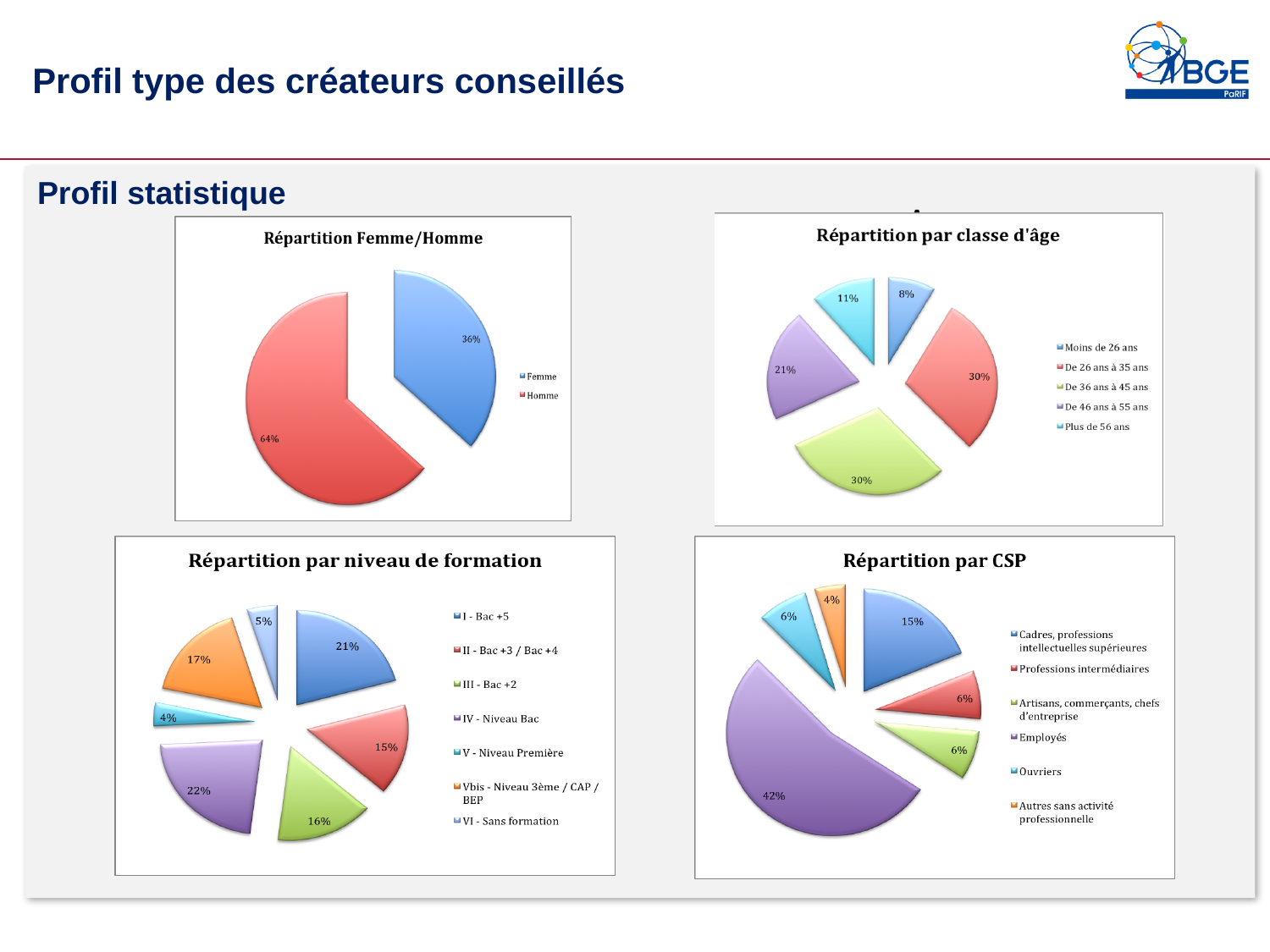
In the 'Répartition par niveau de formation' chart, what share is labelled for 'Vbis - Niveau 3ème / CAP / BEP'? 17% In the 'Répartition par niveau de formation' chart, which is larger: the share for 'I - Bac +5' or for 'II - Bac +3 / Bac +4'? I - Bac +5 In the 'Répartition Femme/Homme' chart, what share is labelled for Homme? 64% In the 'Répartition Femme/Homme' chart, what share is labelled for Femme? 36% In the 'Répartition par classe d'âge' chart, what share is labelled for 'Plus de 56 ans'? 11% In the 'Répartition par classe d'âge' chart, what is the difference between the shares for 'De 46 ans à 55 ans' and 'Moins de 26 ans'? 13% In the 'Répartition par classe d'âge' chart, how many age classes does the legend list? 5 In the 'Répartition par CSP' chart, which category has the smallest share? Autres sans activité professionnelle In the 'Répartition par niveau de formation' chart, which category has the largest share? IV - Niveau Bac In the 'Répartition par classe d'âge' chart, which age class has the smallest share? Moins de 26 ans What type of chart is 'Répartition par CSP'? Pie chart In the 'Répartition par CSP' chart, what share is labelled for Employés? 42%